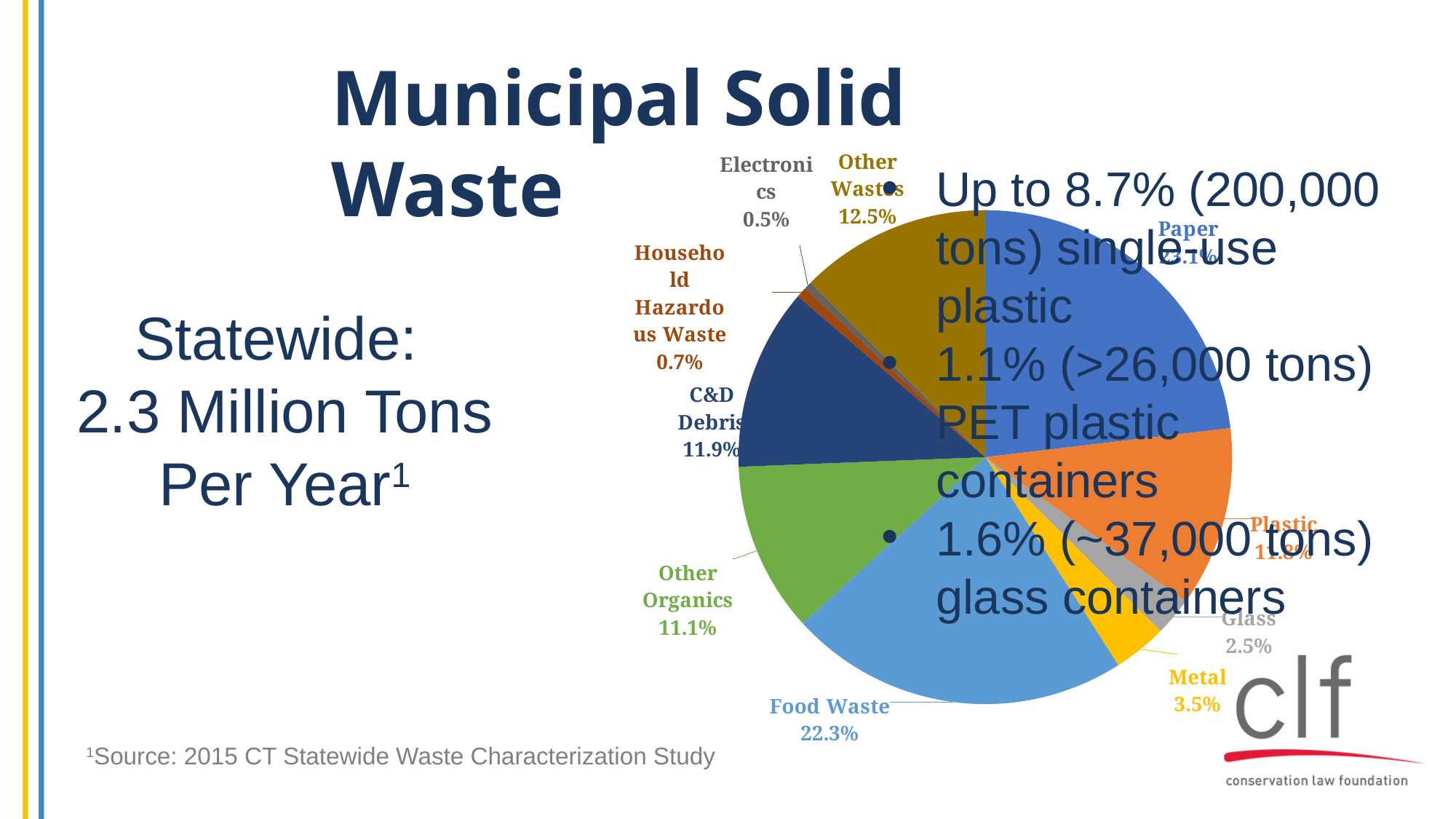
What percentage of municipal solid waste is Food Waste according to the pie chart? 22.3% What is the value shown for Household Hazardous Waste? 0.7% What is the value for Metal in the pie chart? 3.5% What is the value shown for C&D Debris in the pie chart? 11.9% Which category has the smallest share in the pie chart? Electronics Which has a larger share, Metal or Glass? Metal What percentage is labeled for Other Organics? 11.1% What percentage of the pie is Glass? 2.5% What share does Other Wastes have in the pie chart? 12.5% What kind of chart is shown on the slide? Pie chart How many categories are shown in the pie chart? 10 What is the difference between the Food Waste share and the Other Organics share? 11.2%